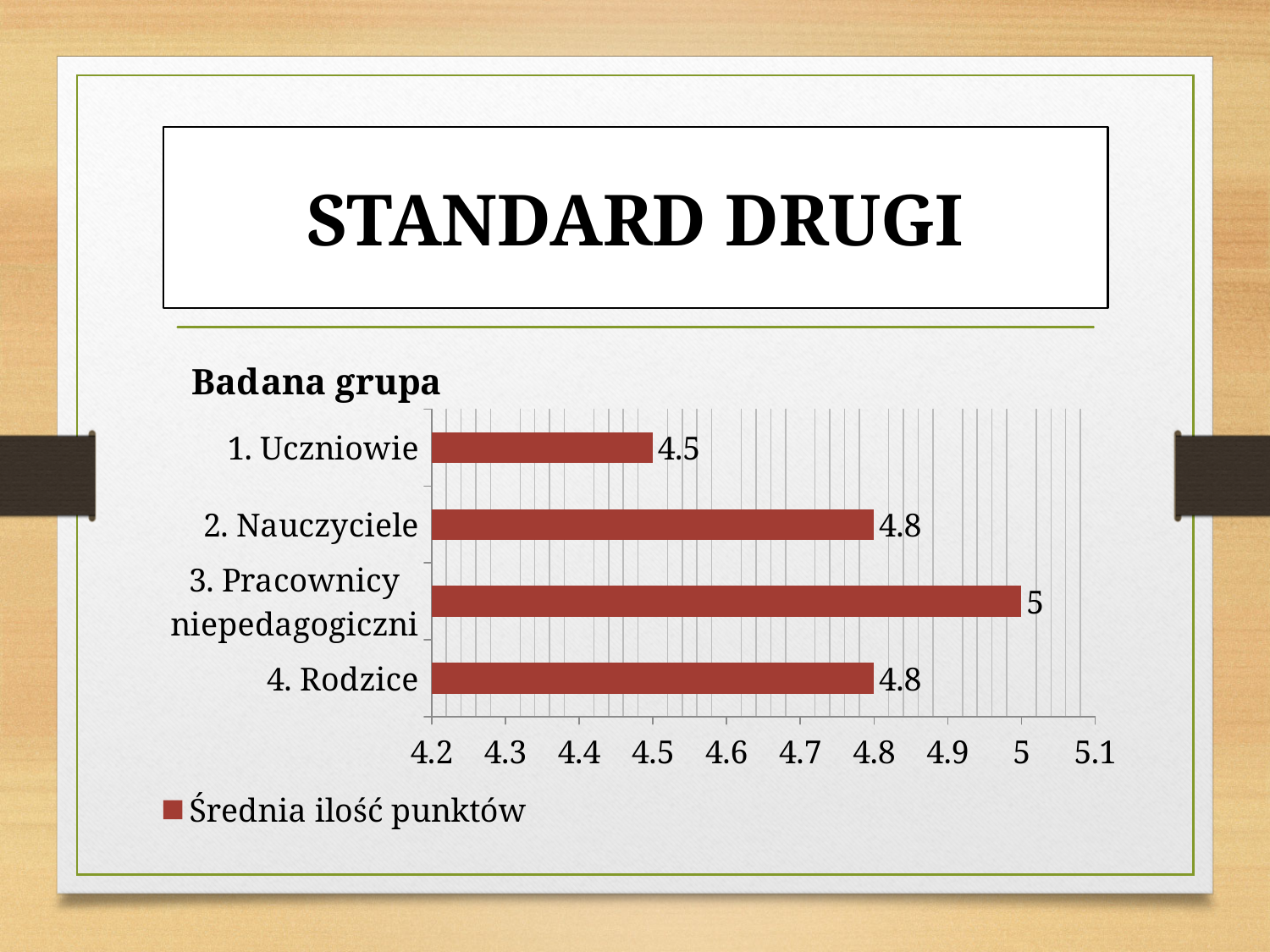
How many categories are shown in the chart? 4 What is the value for 3. Pracownicy niepedagogiczni? 5 What is the value for 4. Rodzice? 4.8 What is the value for 2. Nauczyciele? 4.8 What is the value for 1. Uczniowie? 4.5 Which category has the lowest value? 1. Uczniowie What kind of chart is shown on the slide? bar chart What is the difference between the values for 3. Pracownicy niepedagogiczni and 1. Uczniowie? 0.5 Which category has the highest value? 3. Pracownicy niepedagogiczni Which is larger, the value for 2. Nauczyciele or the value for 1. Uczniowie? 2. Nauczyciele What is the title of the chart? Badana grupa How many series does the legend list? 1